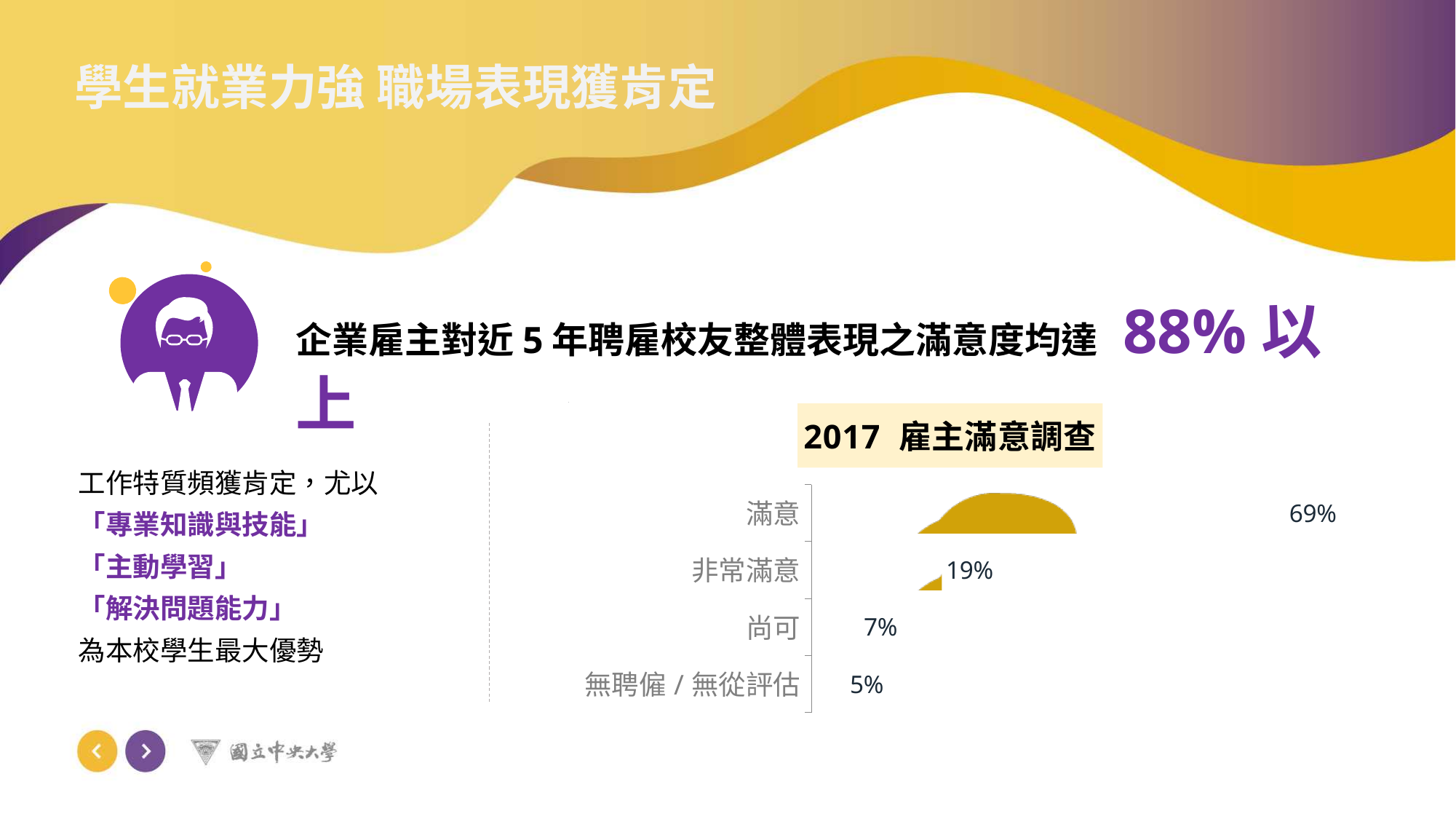
What is the value for 無聘僱 / 無從評估 in the 2017 雇主滿意調查 chart? 5% What is the value for 尚可 in the 2017 雇主滿意調查 chart? 7% What is the title of the chart on the slide? 2017 雇主滿意調查 How many categories are shown in the 2017 雇主滿意調查 chart? 4 What is the difference between the values for 滿意 and 非常滿意 in the 2017 雇主滿意調查 chart? 50% Which category has the highest value in the 2017 雇主滿意調查 chart? 滿意 What is the value for 滿意 in the 2017 雇主滿意調查 chart? 69% What kind of chart is the 2017 雇主滿意調查 chart? bar chart Which category has the lowest value in the 2017 雇主滿意調查 chart? 無聘僱 / 無從評估 What is the difference between the values for 尚可 and 無聘僱 / 無從評估 in the 2017 雇主滿意調查 chart? 2% What is the value for 非常滿意 in the 2017 雇主滿意調查 chart? 19% In the 2017 雇主滿意調查 chart, which is larger: the value for 非常滿意 or the value for 尚可? 非常滿意